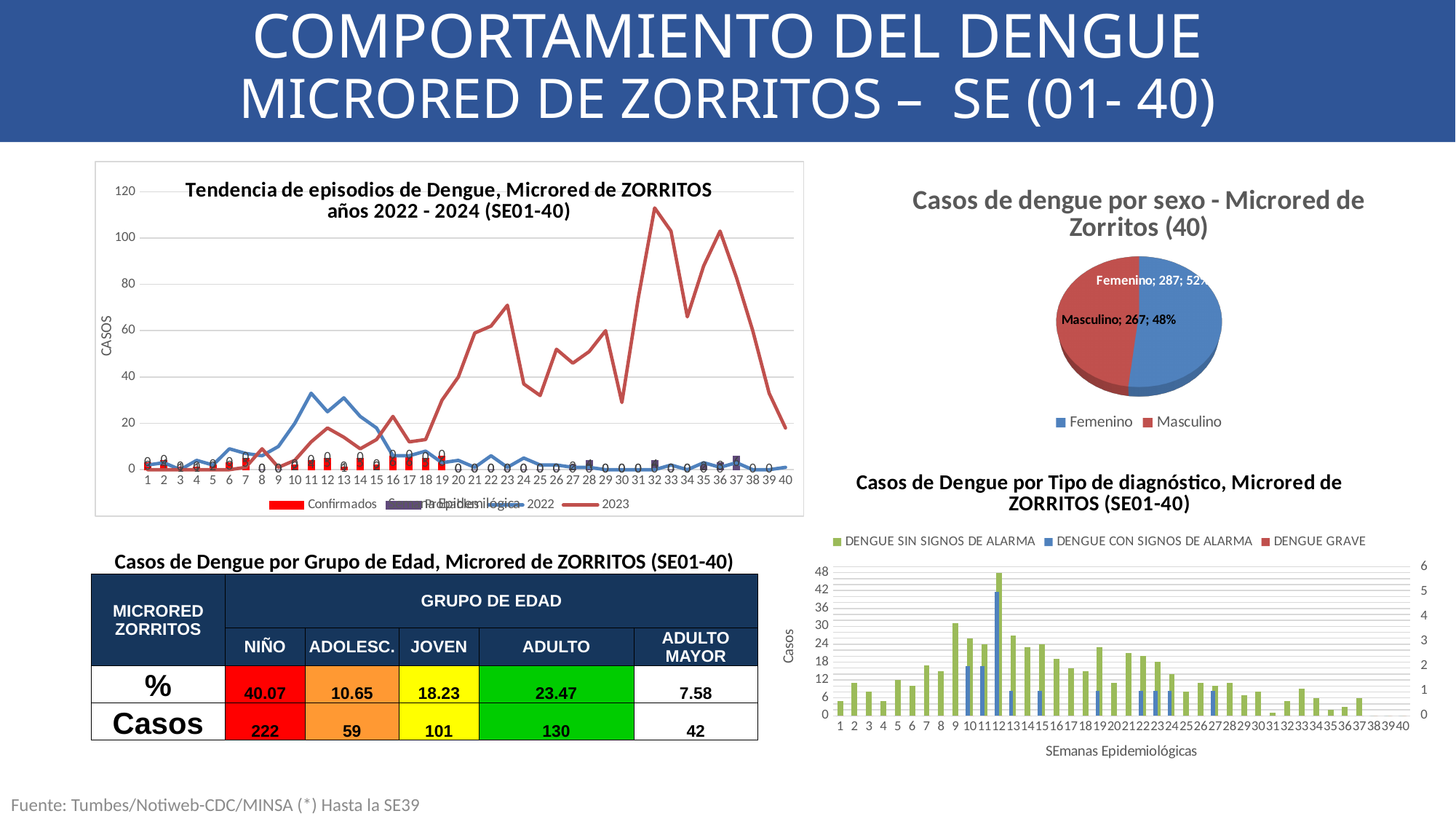
How many entries does the legend of the pie chart 'Casos de dengue por sexo' list? 2 In the pie chart 'Casos de dengue por sexo', how many cases are Femenino? 287 What kind of chart is 'Casos de Dengue por Tipo de diagnóstico, Microred de ZORRITOS (SE01-40)'? bar chart In the line chart 'Tendencia de episodios de Dengue', is the value of the 2023 line at week 32 greater or less than 100? greater In the pie chart 'Casos de dengue por sexo', what is the difference in cases between Femenino and Masculino? 20 In the pie chart 'Casos de dengue por sexo', how many cases are Masculino? 267 In the pie chart 'Casos de dengue por sexo', which category has more cases, Femenino or Masculino? Femenino How many series does the legend of the chart 'Casos de Dengue por Tipo de diagnóstico' list? 3 In the pie chart 'Casos de dengue por sexo', what share of cases is Masculino? 48% In the chart 'Casos de Dengue por Tipo de diagnóstico', in which week is the DENGUE SIN SIGNOS DE ALARMA bar highest? 12 In the line chart 'Tendencia de episodios de Dengue', which year's line reaches the highest values, 2022 or 2023? 2023 In the line chart 'Tendencia de episodios de Dengue', is the value of the 2022 line at week 11 greater or less than 20? greater